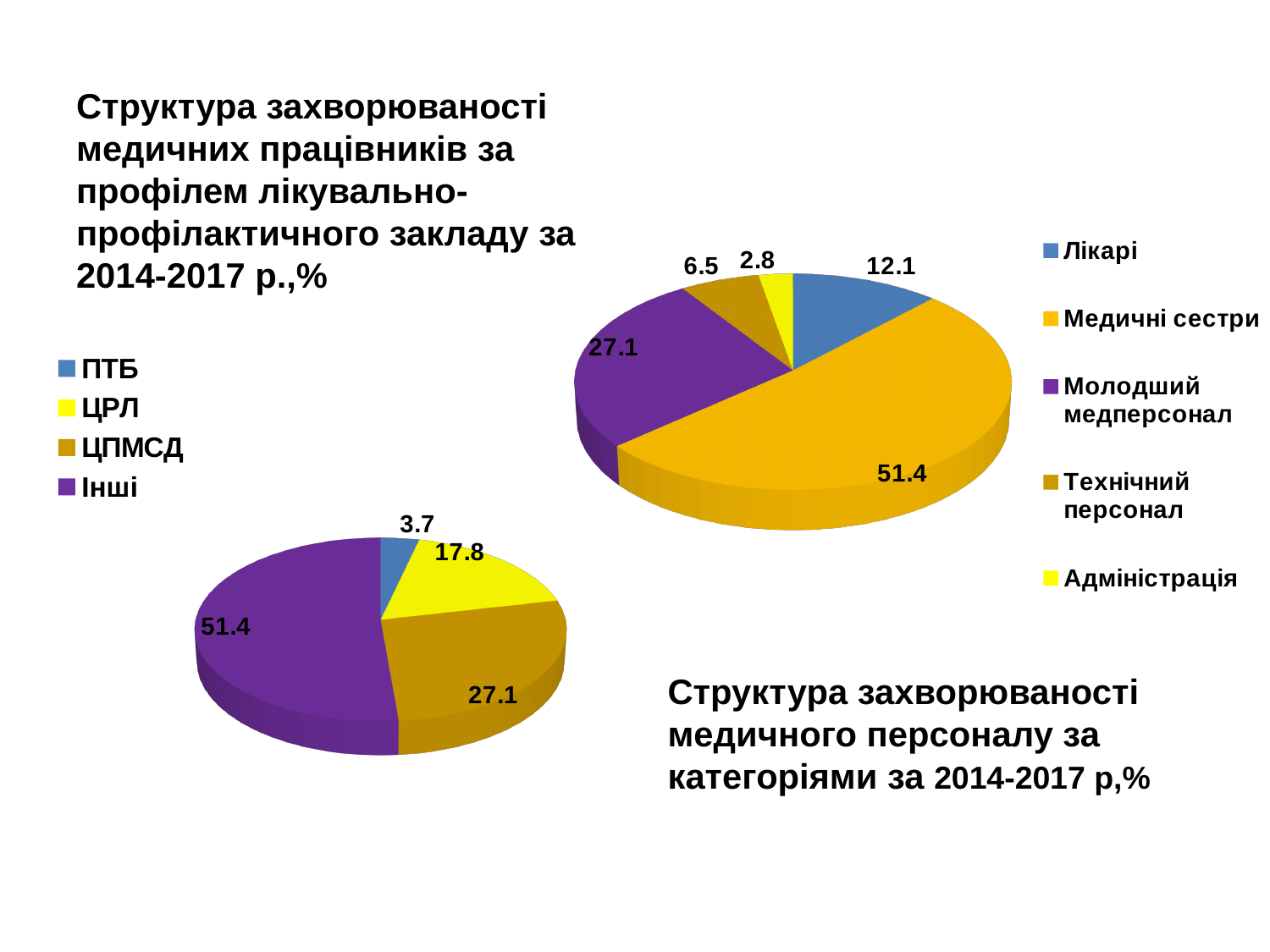
In the pie chart on the right (by staff category), what is the value for Лікарі? 12.1 In the pie chart on the left (by profile of institution), what is the value for ЦРЛ? 17.8 In the pie chart on the right (by staff category), which is larger: Молодший медперсонал or Лікарі? Молодший медперсонал In the pie chart on the right (by staff category), which category has the largest share? Медичні сестри In the pie chart on the right (by staff category), which category has the smallest share? Адміністрація In the pie chart on the left (by profile of institution), what is the difference between the values for Інші and ЦПМСД? 24.3 In the pie chart on the left (by profile of institution), which category has the smallest share? ПТБ In the pie chart on the right (by staff category), what is the value for Технічний персонал? 6.5 In the pie chart on the left (by profile of institution), what is the value for ПТБ? 3.7 In the pie chart on the left (by profile of institution), how many categories are shown? 4 What type of chart is used for both charts on the slide? Pie chart In the pie chart on the left (by profile of institution), which category has the largest share? Інші